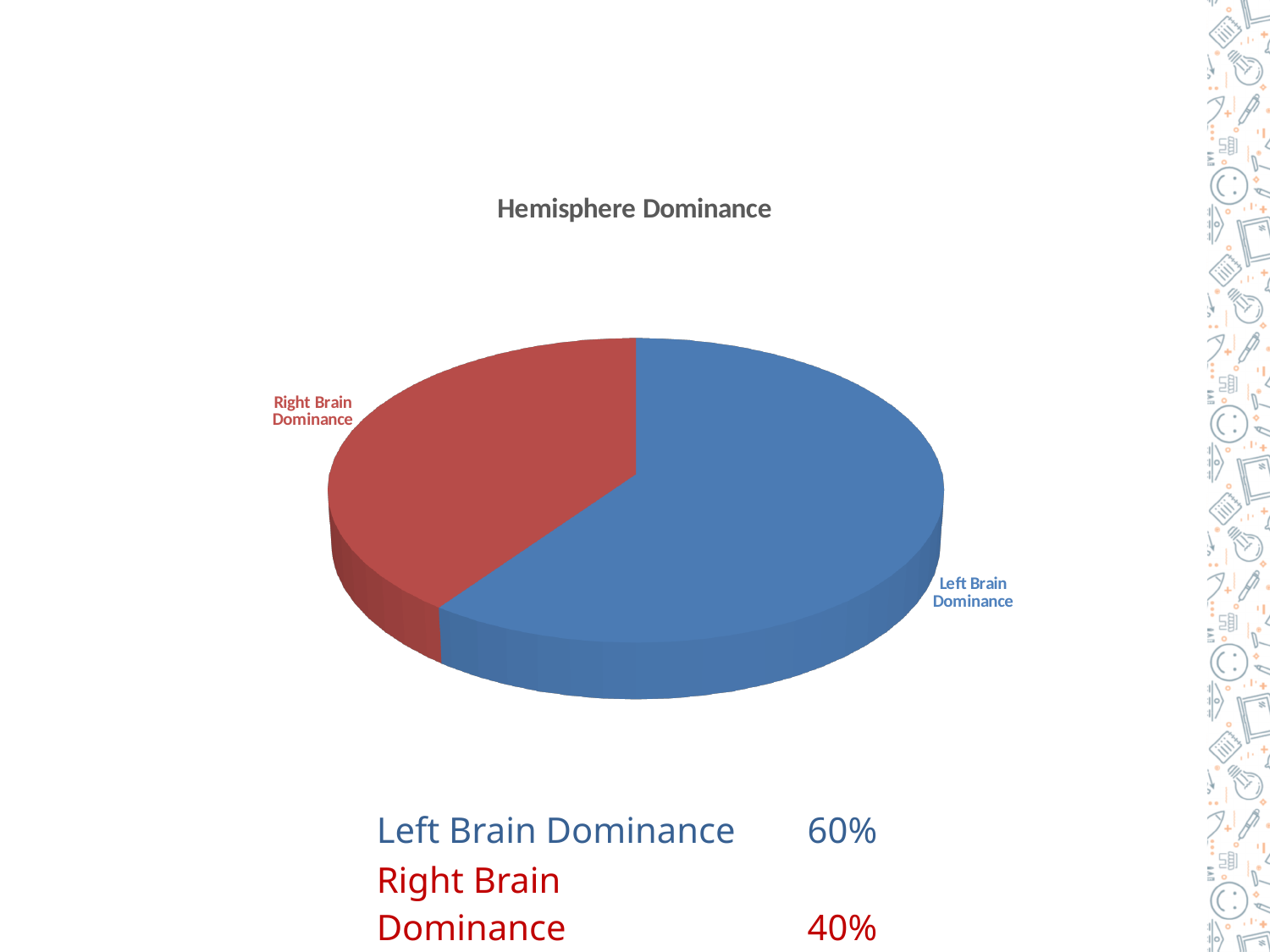
What is the difference in percentage points between Left Brain Dominance and Right Brain Dominance? 20% How many slices does the pie chart have? 2 What share of the pie does Left Brain Dominance represent? 60% What share of the pie does Right Brain Dominance represent? 40% What is the title of the chart? Hemisphere Dominance Which is larger, the Left Brain Dominance slice or the Right Brain Dominance slice? Left Brain Dominance What kind of chart is shown on the slide? pie chart Which slice of the pie chart is the smallest? Right Brain Dominance What colour is the Left Brain Dominance slice? blue Which slice of the pie chart is the largest? Left Brain Dominance Is the share for Right Brain Dominance greater or less than 50%? less